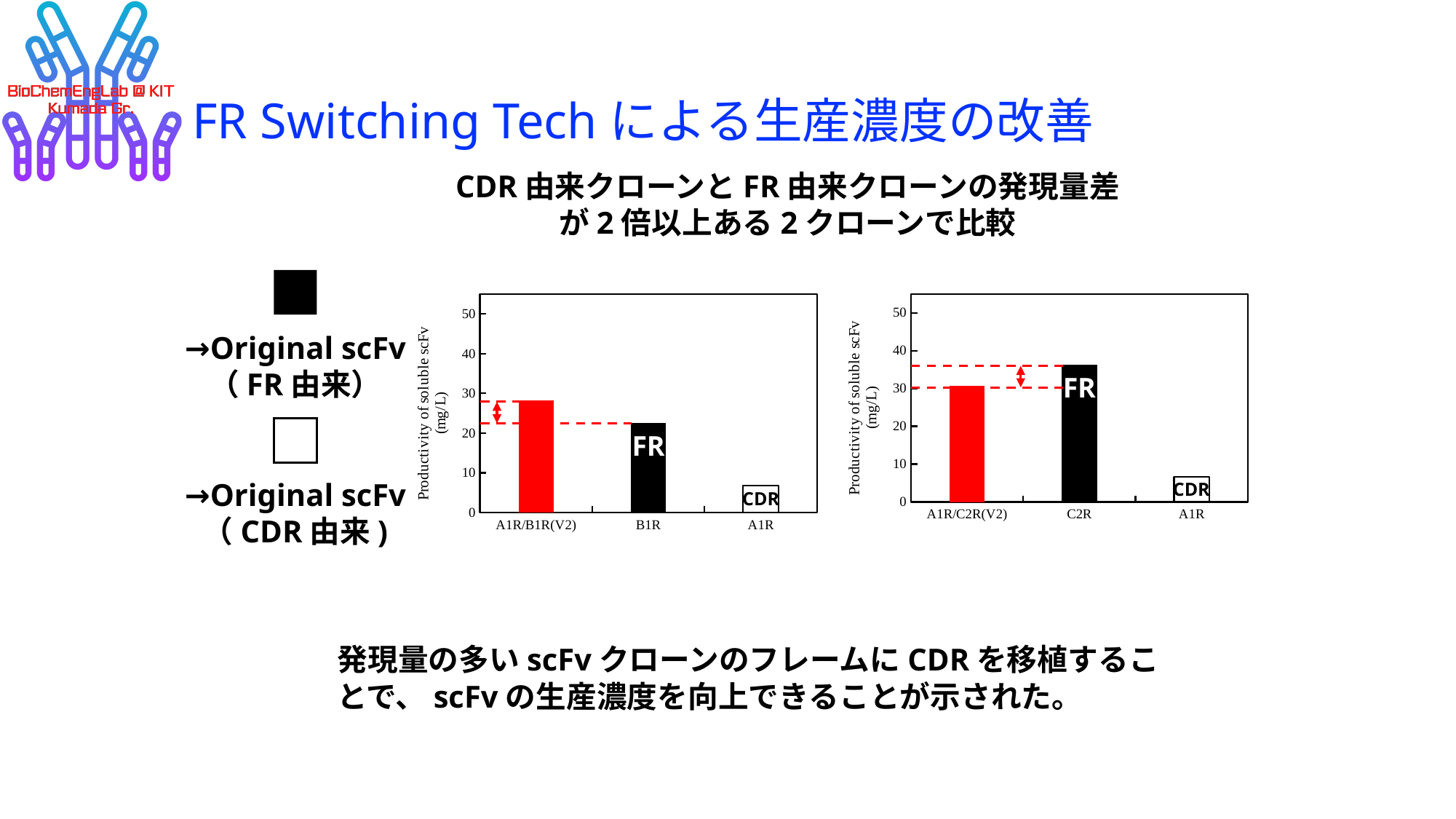
In the right chart, which category has the highest productivity? C2R What is the y-axis label of the left chart? Productivity of soluble scFv (mg/L) In the right chart, which category has the lowest productivity? A1R In the left chart, is the value for A1R greater or less than 10? less In the left chart, which category has the lowest productivity? A1R What kind of chart is the left chart? bar chart In the right chart, is the value for C2R greater or less than 30? greater In the right chart, which is larger, the value for A1R/C2R(V2) or the value for C2R? C2R How many categories are shown on the x axis of the right chart? 3 How many categories are shown on the x axis of the left chart? 3 In the left chart, which category has the highest productivity? A1R/B1R(V2) In the left chart, is the value for A1R/B1R(V2) greater or less than 20? greater